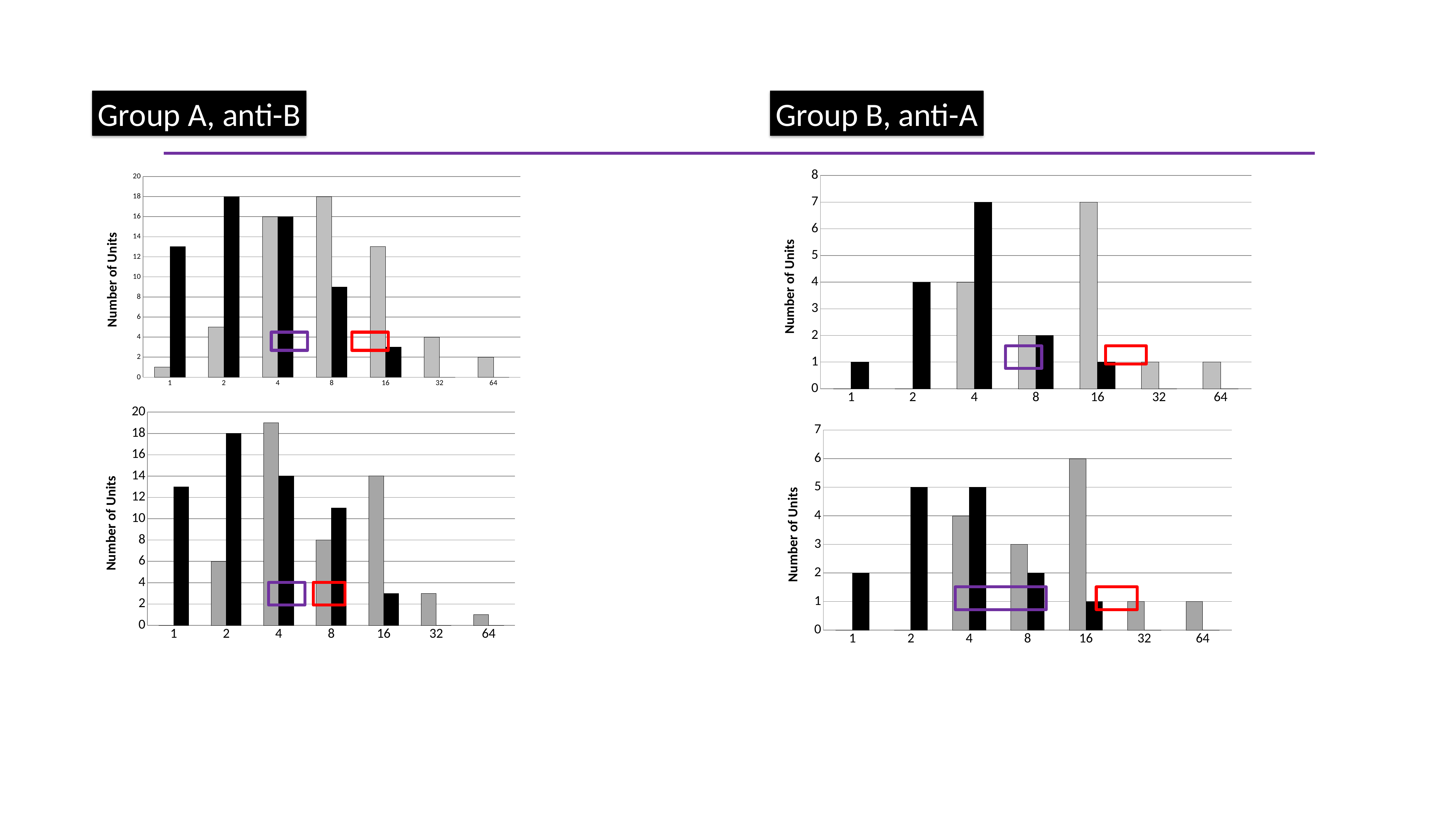
In the top-right chart (Group B, anti-A, top), what is the value of the black bar at category 2? 4 In the bottom-left chart (Group A, anti-B, bottom), which category has the tallest grey bar? 4 In the top-left chart (Group A, anti-B, top), what is the value of the black bar at category 2? 18 In the bottom-right chart (Group B, anti-A, bottom), which is larger at category 8, the grey bar or the black bar? grey bar How many categories are shown on the x axis of the bottom-right chart (Group B, anti-A, bottom)? 7 In the bottom-right chart (Group B, anti-A, bottom), what is the value of the grey bar at category 16? 6 In the bottom-left chart (Group A, anti-B, bottom), is the black bar at category 1 greater or less than 10? greater In the top-left chart (Group A, anti-B, top), what is the value of the grey bar at category 8? 18 In the top-right chart (Group B, anti-A, top), what is the difference between the black bar and the grey bar at category 4? 3 In the top-left chart (Group A, anti-B, top), is the grey bar at category 16 greater or less than 10? greater In the top-right chart (Group B, anti-A, top), what is the value of the grey bar at category 16? 7 In the bottom-left chart (Group A, anti-B, bottom), what is the value of the grey bar at category 16? 14